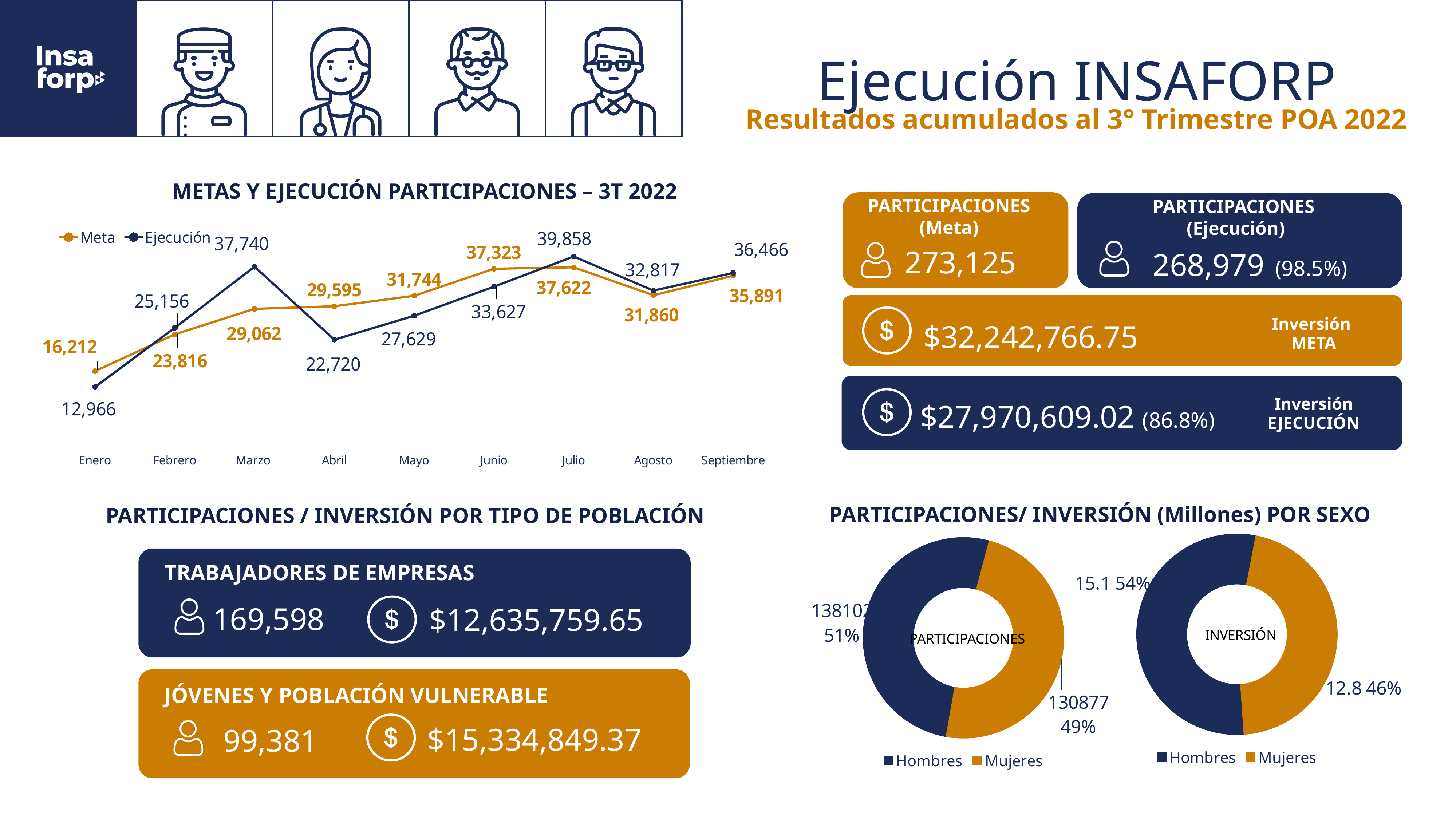
In the chart 'METAS Y EJECUCIÓN PARTICIPACIONES – 3T 2022', does the Meta series rise or fall from Enero to Febrero? Rise In the chart 'METAS Y EJECUCIÓN PARTICIPACIONES – 3T 2022', which month has the lowest Meta value? Enero In the PARTICIPACIONES donut chart under 'PARTICIPACIONES/ INVERSIÓN (Millones) POR SEXO', what share is Mujeres? 49% What type of chart is 'METAS Y EJECUCIÓN PARTICIPACIONES – 3T 2022'? Line chart In the chart 'METAS Y EJECUCIÓN PARTICIPACIONES – 3T 2022', what is the Ejecución value for Julio? 39,858 In the INVERSIÓN donut chart under 'PARTICIPACIONES/ INVERSIÓN (Millones) POR SEXO', what is the value for Hombres? 15.1 In the chart 'METAS Y EJECUCIÓN PARTICIPACIONES – 3T 2022', what is the difference between the Ejecución and Meta values for Marzo? 8,678 In the chart 'METAS Y EJECUCIÓN PARTICIPACIONES – 3T 2022', which is larger for Abril, Meta or Ejecución? Meta In the chart 'METAS Y EJECUCIÓN PARTICIPACIONES – 3T 2022', which month has the highest Ejecución value? Julio How many months are plotted on the x axis of the chart 'METAS Y EJECUCIÓN PARTICIPACIONES – 3T 2022'? 9 How many series does the legend of the chart 'METAS Y EJECUCIÓN PARTICIPACIONES – 3T 2022' list? 2 In the chart 'METAS Y EJECUCIÓN PARTICIPACIONES – 3T 2022', what is the Meta value for Enero? 16,212